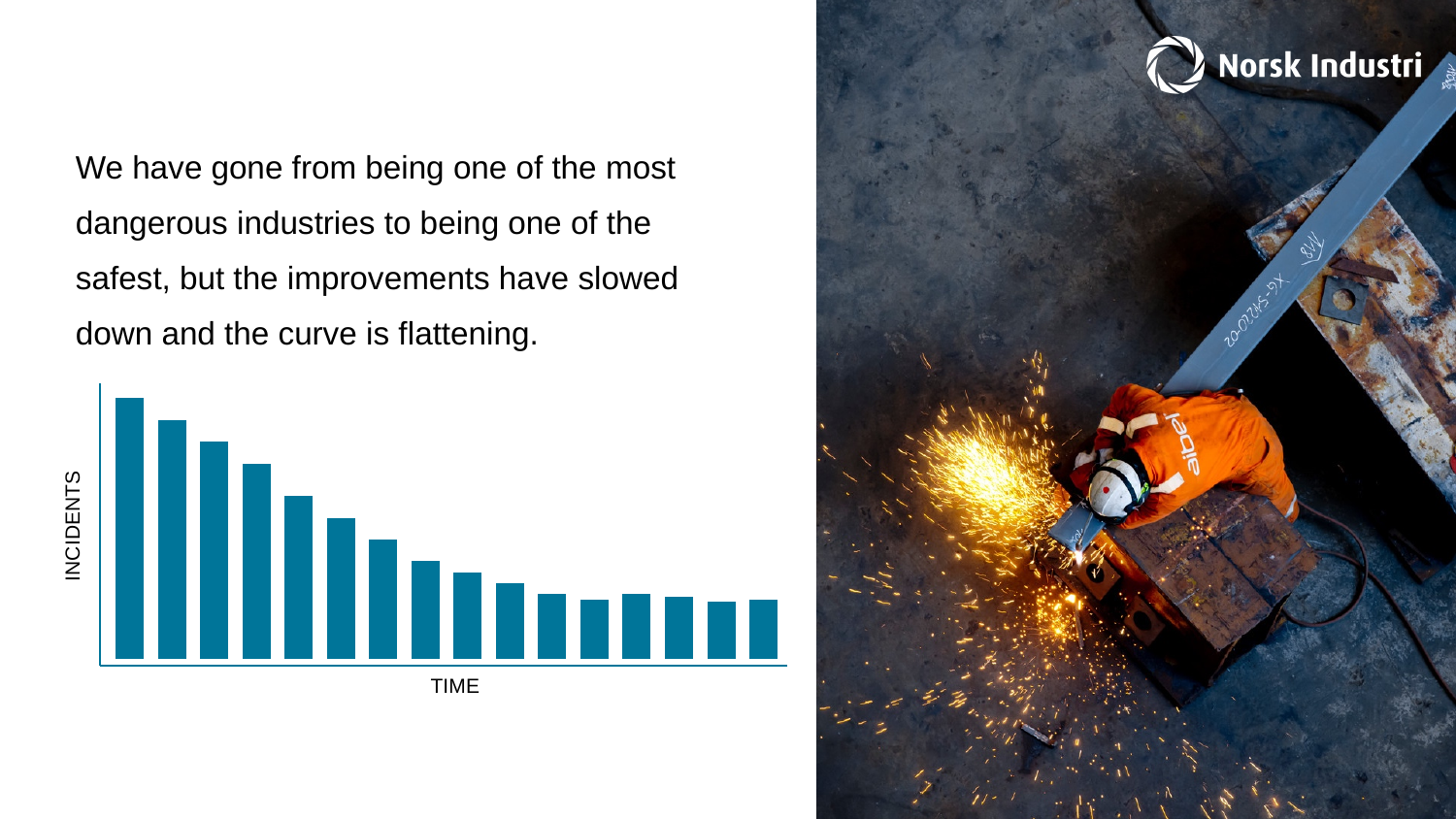
How many bars does the chart contain? 16 What is the label on the vertical (y) axis of the chart? INCIDENTS Which is larger, the leftmost bar or the rightmost bar? The leftmost bar Do the values in the chart rise or fall from left to right along the x axis? Fall What kind of chart is shown on the slide? Bar chart Which is larger, the fifth bar or the tenth bar from the left? The fifth bar Which bar in the chart is the highest? The leftmost (first) bar What is the label on the horizontal (x) axis of the chart? TIME Which is larger, the first bar or the second bar from the left? The first bar